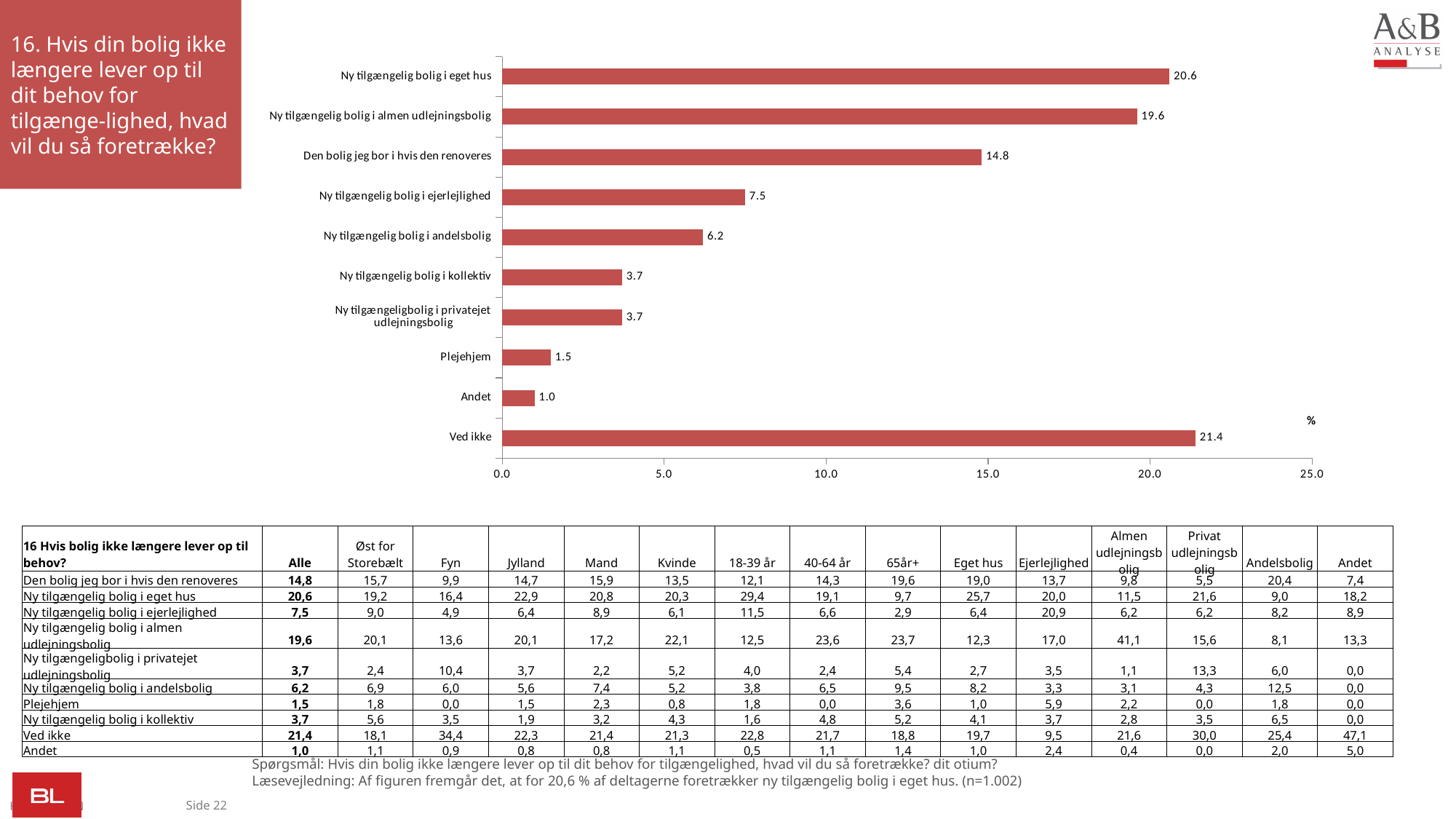
Which category has the highest value in the chart? Ved ikke Which is larger: the value for "Ny tilgængelig bolig i ejerlejlighed" or for "Ny tilgængelig bolig i andelsbolig"? Ny tilgængelig bolig i ejerlejlighed What value is shown for "Plejehjem"? 1.5 Is the value for "Ny tilgængelig bolig i ejerlejlighed" greater or less than 10.0? less Is the value for "Ved ikke" greater or less than 20.0? greater What value is shown for "Ny tilgængelig bolig i eget hus"? 20.6 What is the difference between the values for "Ny tilgængelig bolig i eget hus" and "Den bolig jeg bor i hvis den renoveres"? 5.8 What kind of chart is shown on the slide? Bar chart What value is shown for "Den bolig jeg bor i hvis den renoveres"? 14.8 How many categories are plotted in the chart? 10 Which category has the lowest value in the chart? Andet What is the difference between the values for "Ny tilgængelig bolig i almen udlejningsbolig" and "Ny tilgængelig bolig i ejerlejlighed"? 12.1